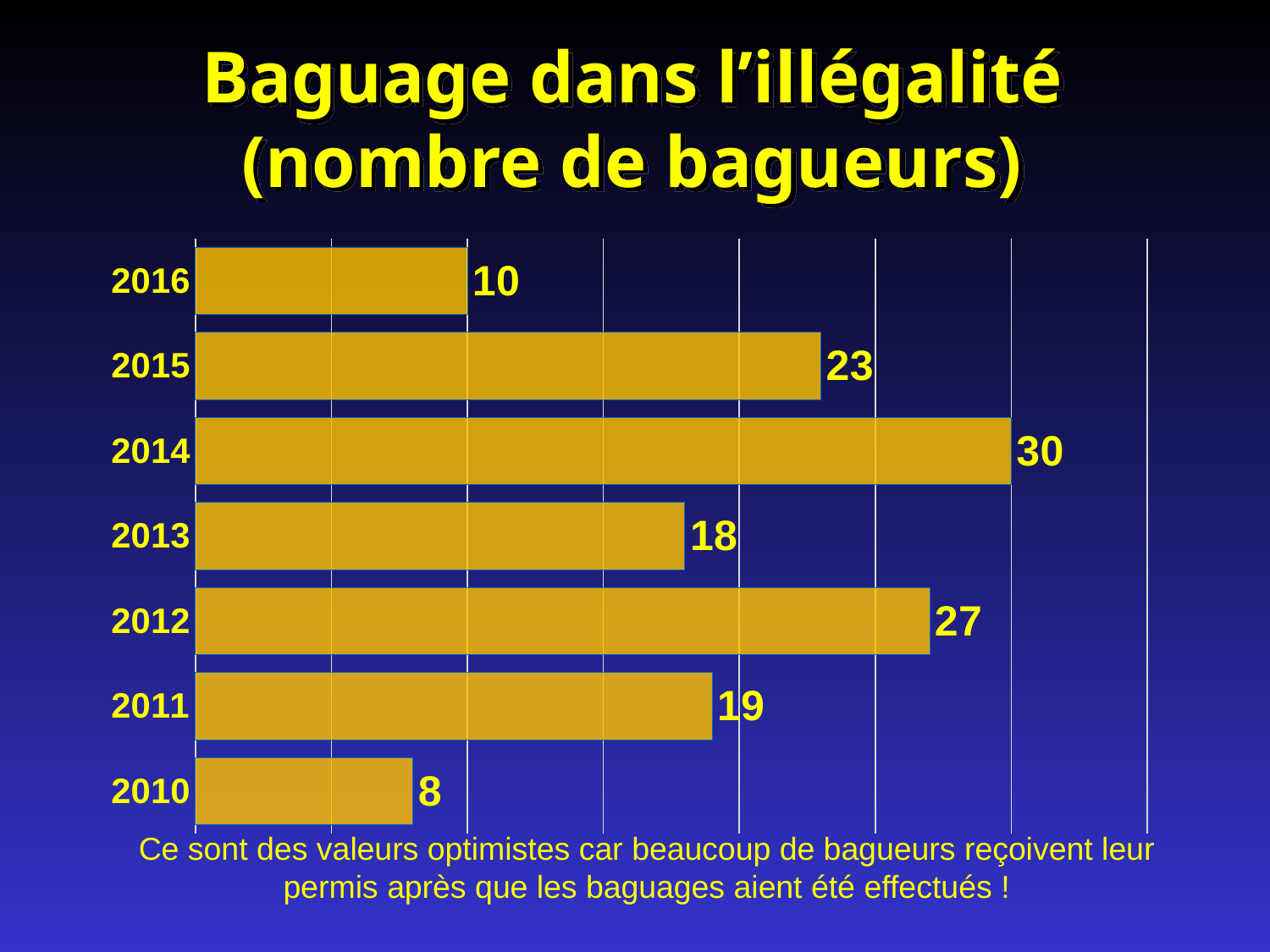
How many years are shown in the chart? 7 What is the value for 2014? 30 What is the value for 2010? 8 Which year has the lowest value? 2010 What is the difference between the values for 2014 and 2016? 20 Which is larger, the value for 2012 or the value for 2015? 2012 What is the value for 2012? 27 Which year has the highest value? 2014 What is the title of the chart? Baguage dans l'illégalité (nombre de bagueurs) Which is larger, the value for 2011 or the value for 2013? 2011 What is the difference between the values for 2015 and 2013? 5 What kind of chart is this? bar chart